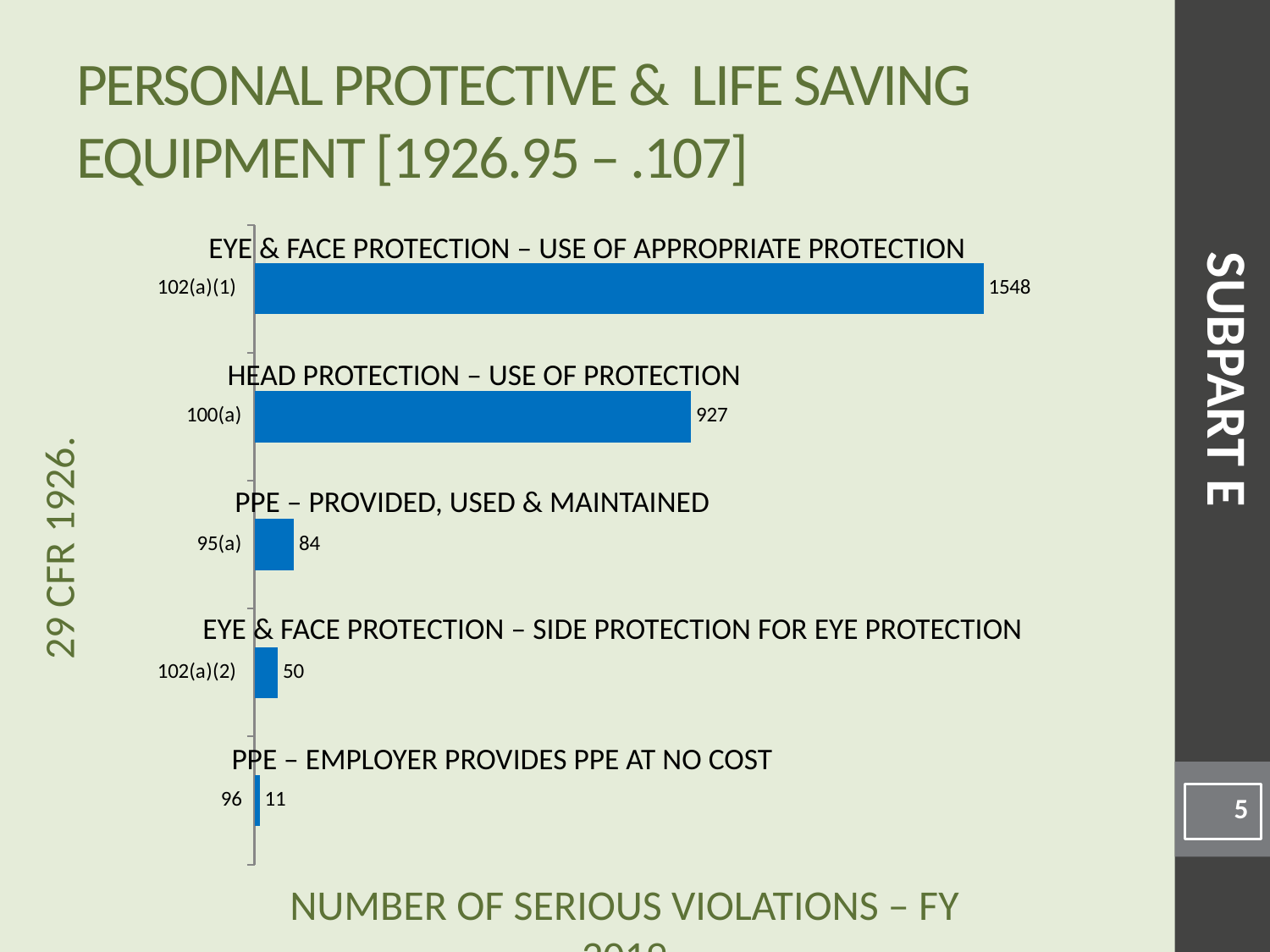
What is the number of serious violations for 102(a)(1), Eye & Face Protection – Use of Appropriate Protection? 1548 What is the difference in serious violations between 102(a)(1) and 100(a)? 621 What is the difference in serious violations between 95(a) and 102(a)(2)? 34 Which standard has the lowest number of serious violations? 96 Which standard has the highest number of serious violations? 102(a)(1) What is the number of serious violations for 96, PPE – Employer Provides PPE at No Cost? 11 What is the number of serious violations for 95(a), PPE – Provided, Used & Maintained? 84 Which has more serious violations, 100(a) or 95(a)? 100(a) How many standards are shown in the chart? 5 What is the number of serious violations for 100(a), Head Protection – Use of Protection? 927 What kind of chart is shown on the slide? Bar chart What is the number of serious violations for 102(a)(2), Eye & Face Protection – Side Protection for Eye Protection? 50